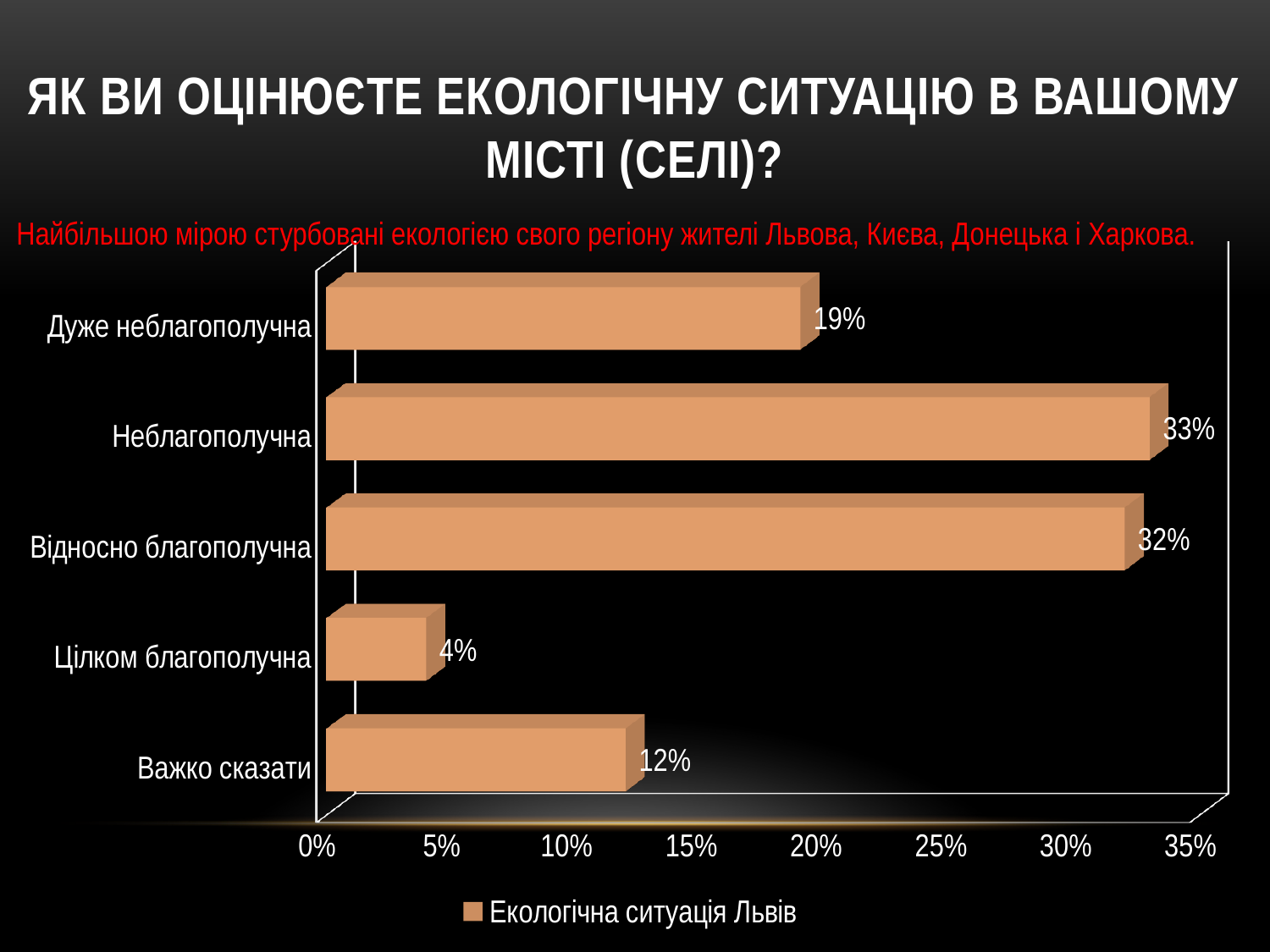
What is the value for Дуже неблагополучна? 19% Which category has the highest value? Неблагополучна Which category has the lowest value? Цілком благополучна What is the value for Важко сказати? 12% What series name does the legend show? Екологічна ситуація Львів How many categories are shown in the chart? 5 What is the difference between the values for Дуже неблагополучна and Важко сказати? 7% Which is larger, the value for Дуже неблагополучна or the value for Цілком благополучна? Дуже неблагополучна What is the value for Відносно благополучна? 32% What is the value for Неблагополучна? 33% What kind of chart is shown on the slide? Bar chart What is the value for Цілком благополучна? 4%